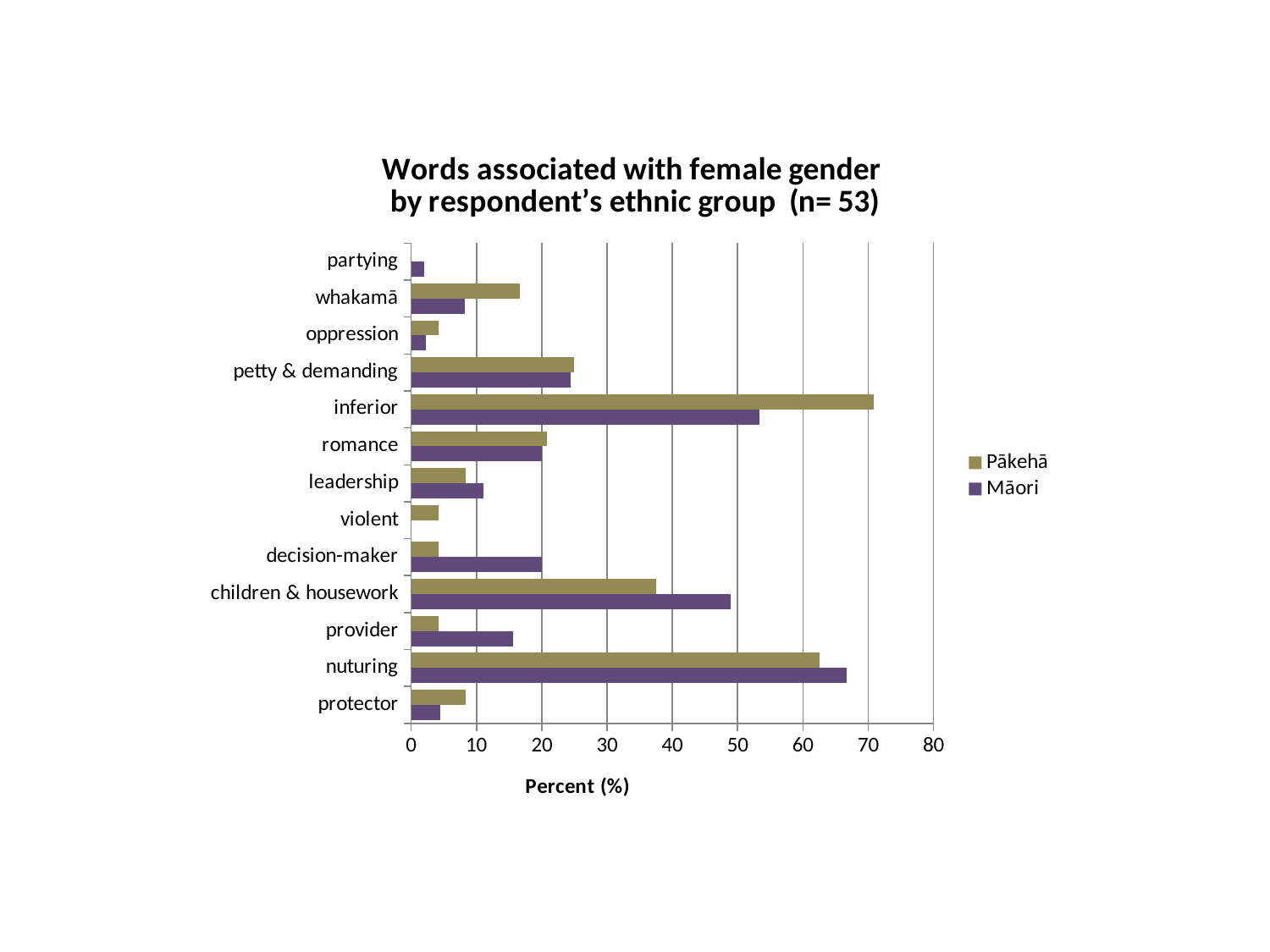
Which word has the highest Māori value? nuturing What kind of chart is shown on the slide? bar chart Is the Pākehā value for 'inferior' greater or less than 60? greater For 'children & housework', which group has the larger value, Pākehā or Māori? Māori How many word categories are plotted on the chart? 13 Is the Māori value for 'provider' greater or less than 10? greater Which word has the highest Pākehā value? inferior For 'inferior', which group has the larger value, Pākehā or Māori? Pākehā What is the label of the horizontal axis? Percent (%) Is the Pākehā value for 'whakamā' greater or less than 10? greater How many series does the legend list? 2 For 'decision-maker', which group has the larger value, Pākehā or Māori? Māori